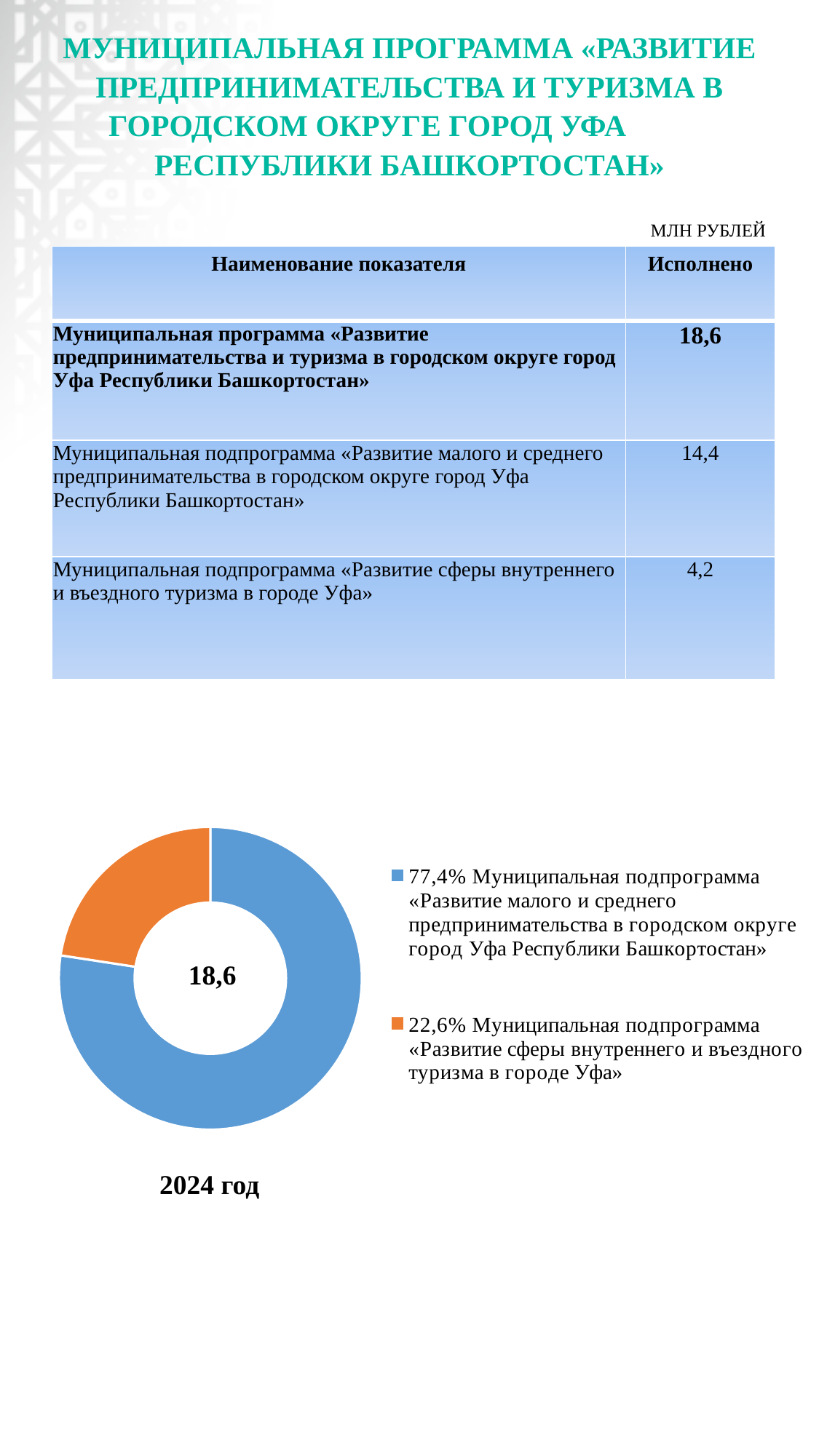
Which is larger in the chart: the share of the small and medium business subprogram or the share of the tourism subprogram? the small and medium business subprogram How many entries does the chart legend list? 2 What value is printed in the centre of the doughnut chart? 18,6 By how many percentage points does the share of the small and medium business subprogram exceed the share of the tourism subprogram in the chart? 54,8% Which slice of the chart is the smallest? Муниципальная подпрограмма «Развитие сферы внутреннего и въездного туризма в городе Уфа» What kind of chart is shown on the slide? doughnut chart What year is labelled below the chart? 2024 год What share of the chart does the subprogram «Развитие малого и среднего предпринимательства в городском округе город Уфа Республики Башкортостан» take? 77,4% What colour is the slice for the tourism subprogram «Развитие сферы внутреннего и въездного туризма в городе Уфа»? orange Which slice of the chart is the largest? Муниципальная подпрограмма «Развитие малого и среднего предпринимательства в городском округе город Уфа Республики Башкортостан» What share of the chart does the subprogram «Развитие сферы внутреннего и въездного туризма в городе Уфа» take? 22,6% How many slices does the chart have? 2